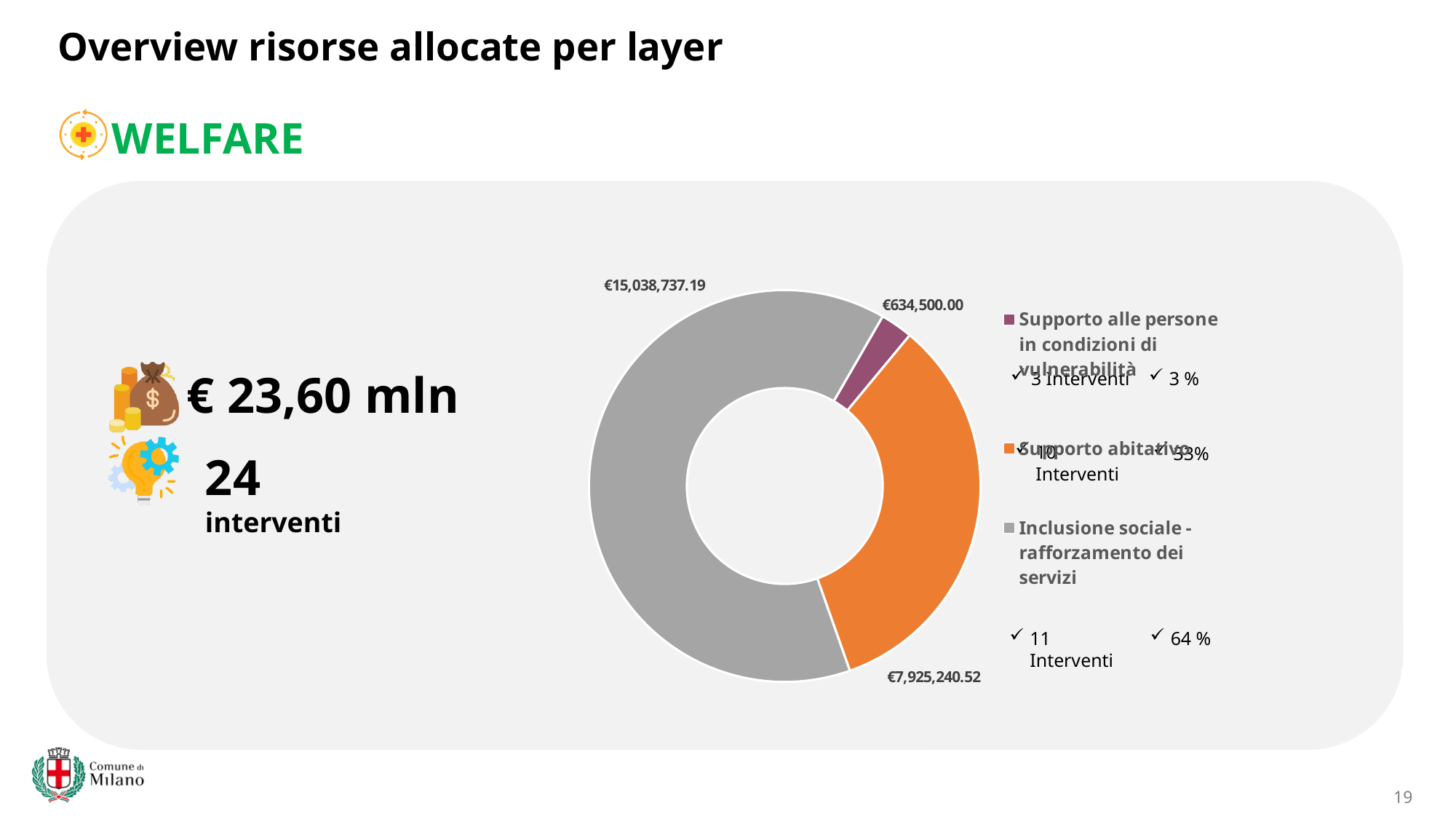
Which category has the largest slice of the doughnut chart? Inclusione sociale - rafforzamento dei servizi How many slices does the doughnut chart have? 3 Which colour represents Supporto abitativo in the doughnut chart? orange What is the value for Supporto alle persone in condizioni di vulnerabilità? €634,500.00 What is the value for Supporto abitativo? €7,925,240.52 What is the difference between the value for Inclusione sociale - rafforzamento dei servizi and the value for Supporto abitativo? €7,113,496.67 Which is larger, the value for Supporto abitativo or the value for Supporto alle persone in condizioni di vulnerabilità? Supporto abitativo What kind of chart is shown on the slide? doughnut chart Which category has the smallest slice of the doughnut chart? Supporto alle persone in condizioni di vulnerabilità What share of the total does Supporto abitativo represent, according to the slide? 33 % What is the value for Inclusione sociale - rafforzamento dei servizi? €15,038,737.19 How many entries does the legend of the doughnut chart list? 3